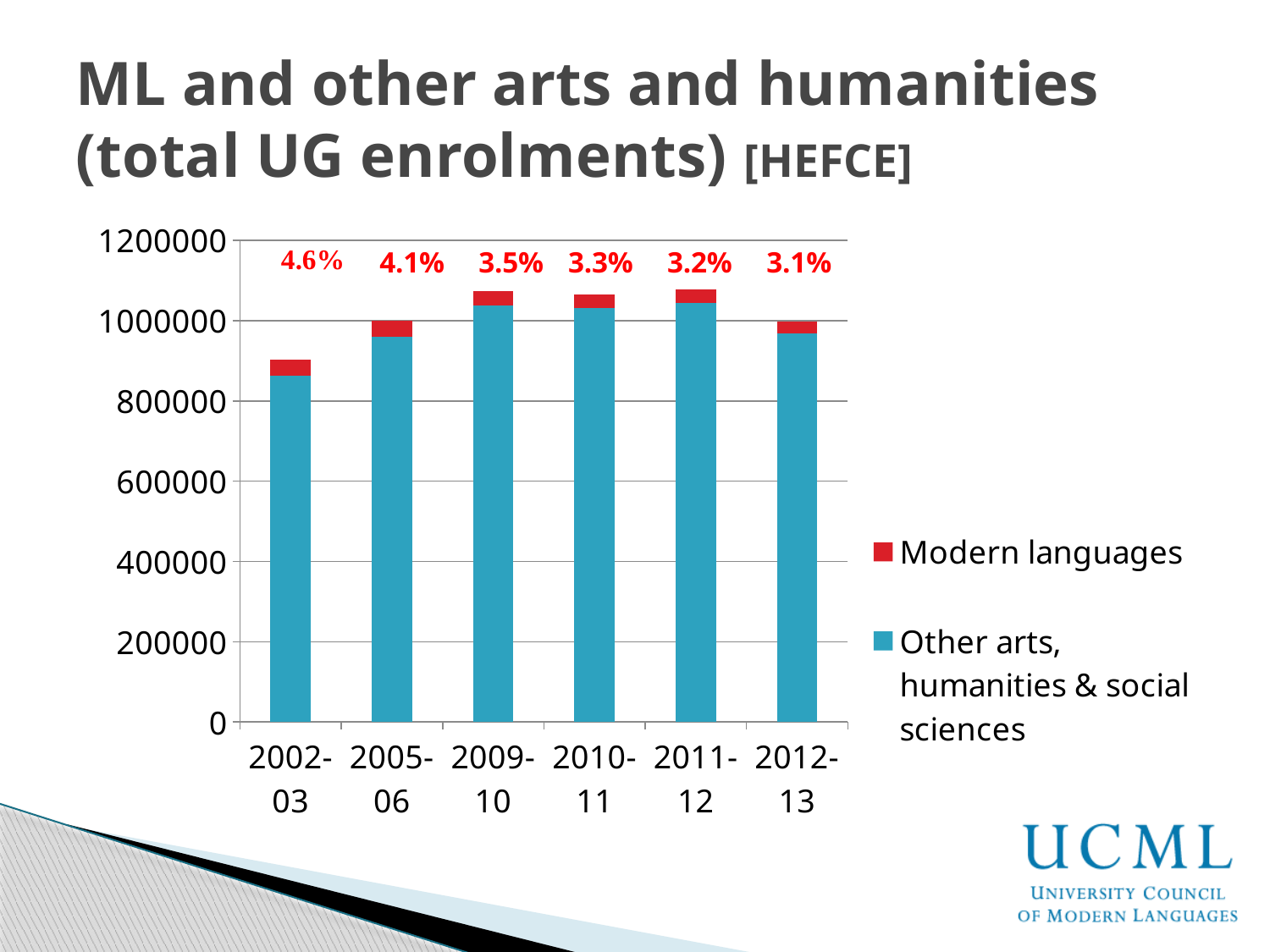
Which series is shown in red in the legend? Modern languages Which year has the highest percentage label printed above its bar? 2002-03 Which year has the lowest total bar height? 2002-03 What percentage label is printed above the 2002-03 bar? 4.6% How many academic-year categories are shown on the x axis? 6 What percentage label is printed above the 2009-10 bar? 3.5% Is the total bar for 2002-03 greater or less than 1000000? less What kind of chart is shown on the slide? stacked bar chart Is the total bar for 2011-12 greater or less than 1000000? greater How many series does the legend list? 2 Do the percentage labels above the bars rise or fall from 2002-03 to 2012-13? fall What percentage label is printed above the 2012-13 bar? 3.1%